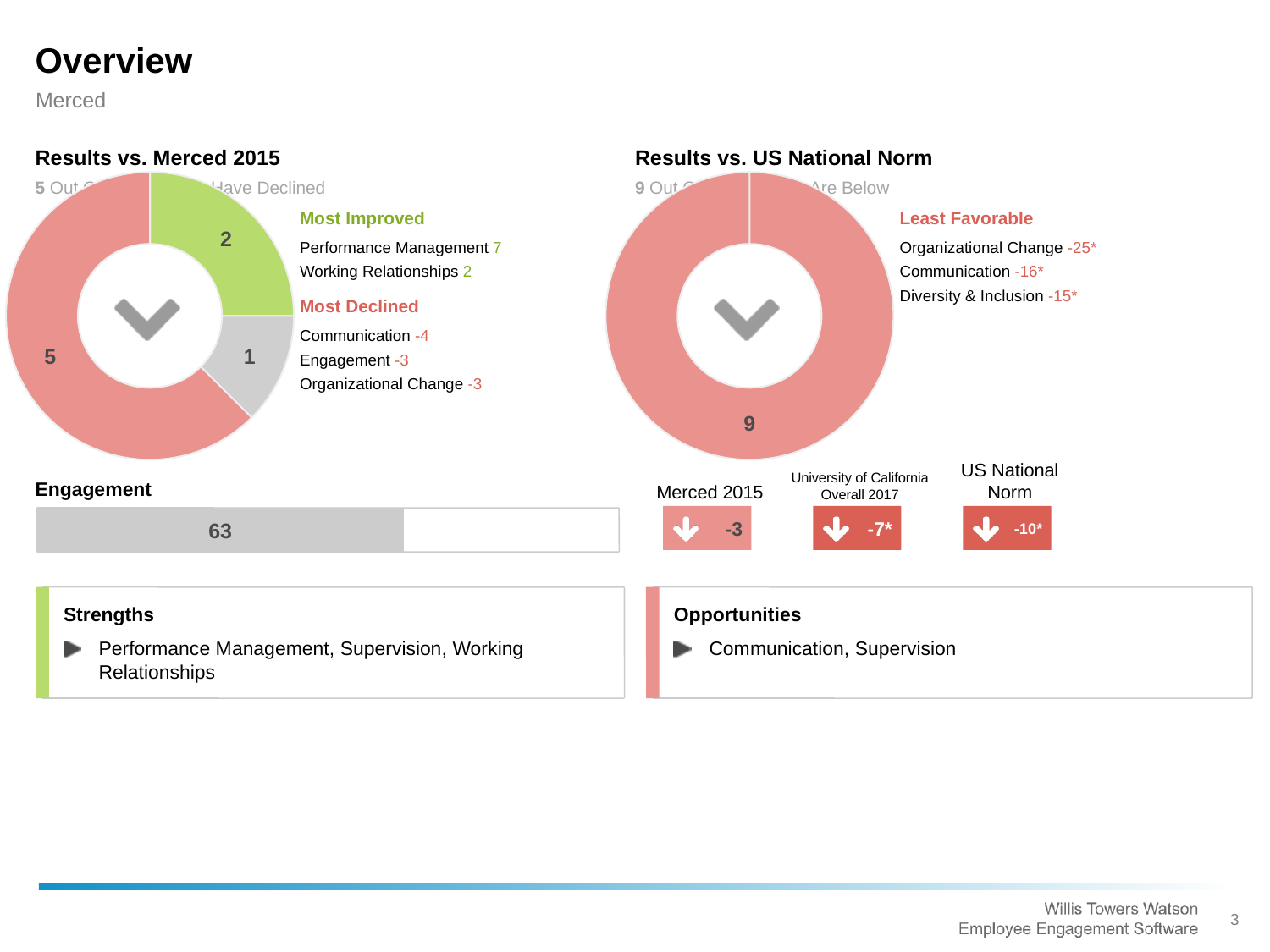
What value is shown in the Results vs. US National Norm donut chart? 9 How many segments does the Results vs. US National Norm donut chart have? 1 In the Results vs. Merced 2015 donut chart, what colour is the largest segment? Red What kind of chart is used for Results vs. Merced 2015? Donut (pie) chart In the Results vs. Merced 2015 donut chart, which is larger: the red segment or the green segment? The red segment (5) In the Results vs. Merced 2015 donut chart, what is the difference between the red segment (5) and the green segment (2)? 3 How many segments does the Results vs. Merced 2015 donut chart have? 3 What is the Engagement comparison value shown for Merced 2015? -3 What is the total of the segment values in the Results vs. Merced 2015 donut chart? 8 In the Results vs. Merced 2015 donut chart, what is the smallest segment value? 1 What value is shown on the Engagement bar? 63 In the Results vs. Merced 2015 donut chart, what is the largest segment value? 5